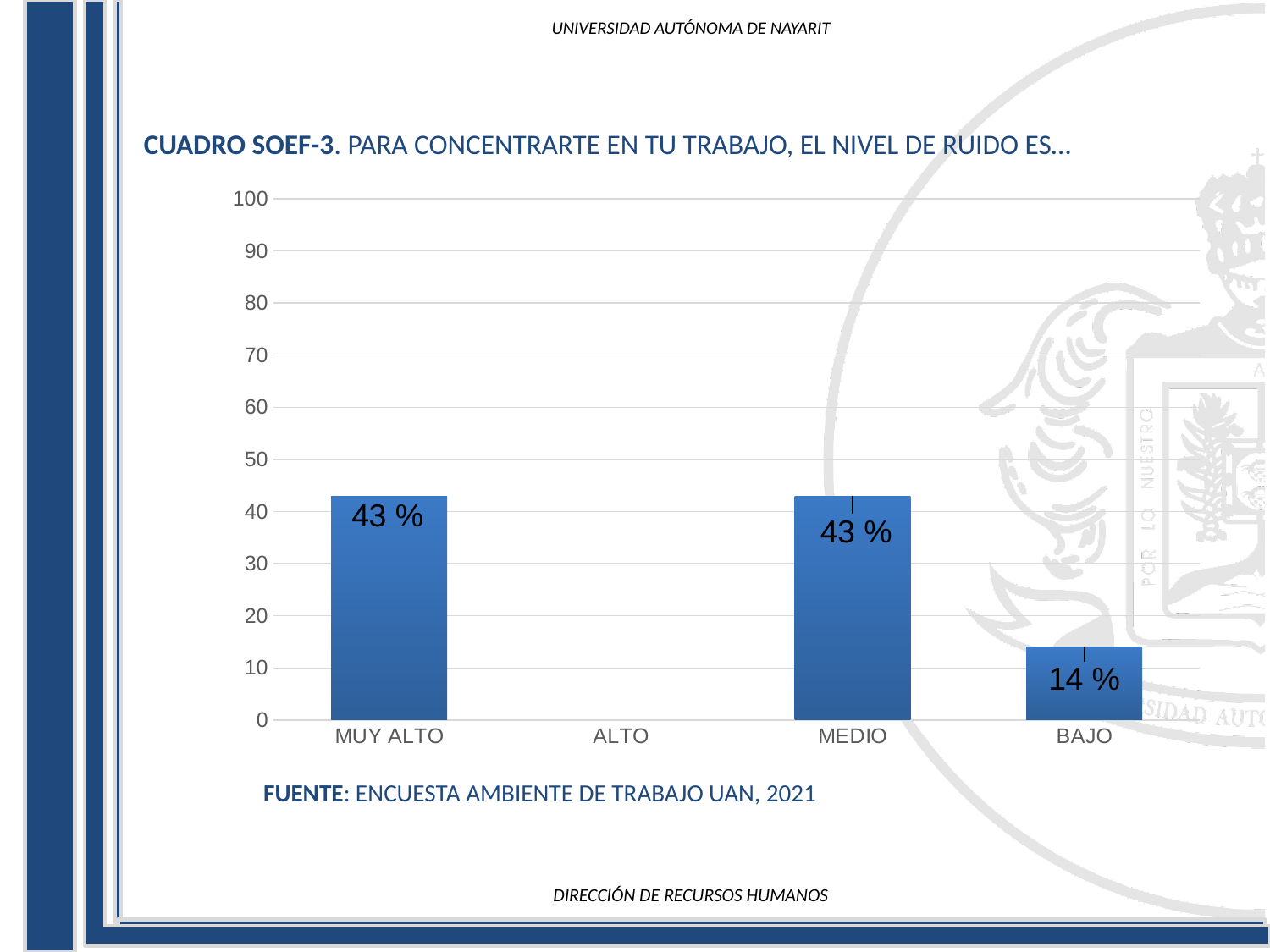
What is the value for BAJO? 14 % Is the value for MEDIO greater or less than 40? greater What is the difference between the values for MEDIO and BAJO? 29 % Is the value for BAJO greater or less than 20? less What is the maximum value shown on the y axis? 100 What is the value for MEDIO? 43 % Which category has the lowest value among those with a visible bar? BAJO What kind of chart is shown on the slide? bar chart How many categories are shown on the x axis? 4 What is the value for MUY ALTO? 43 % Which is larger, the value for MUY ALTO or the value for BAJO? MUY ALTO Which category on the x axis has no visible bar? ALTO